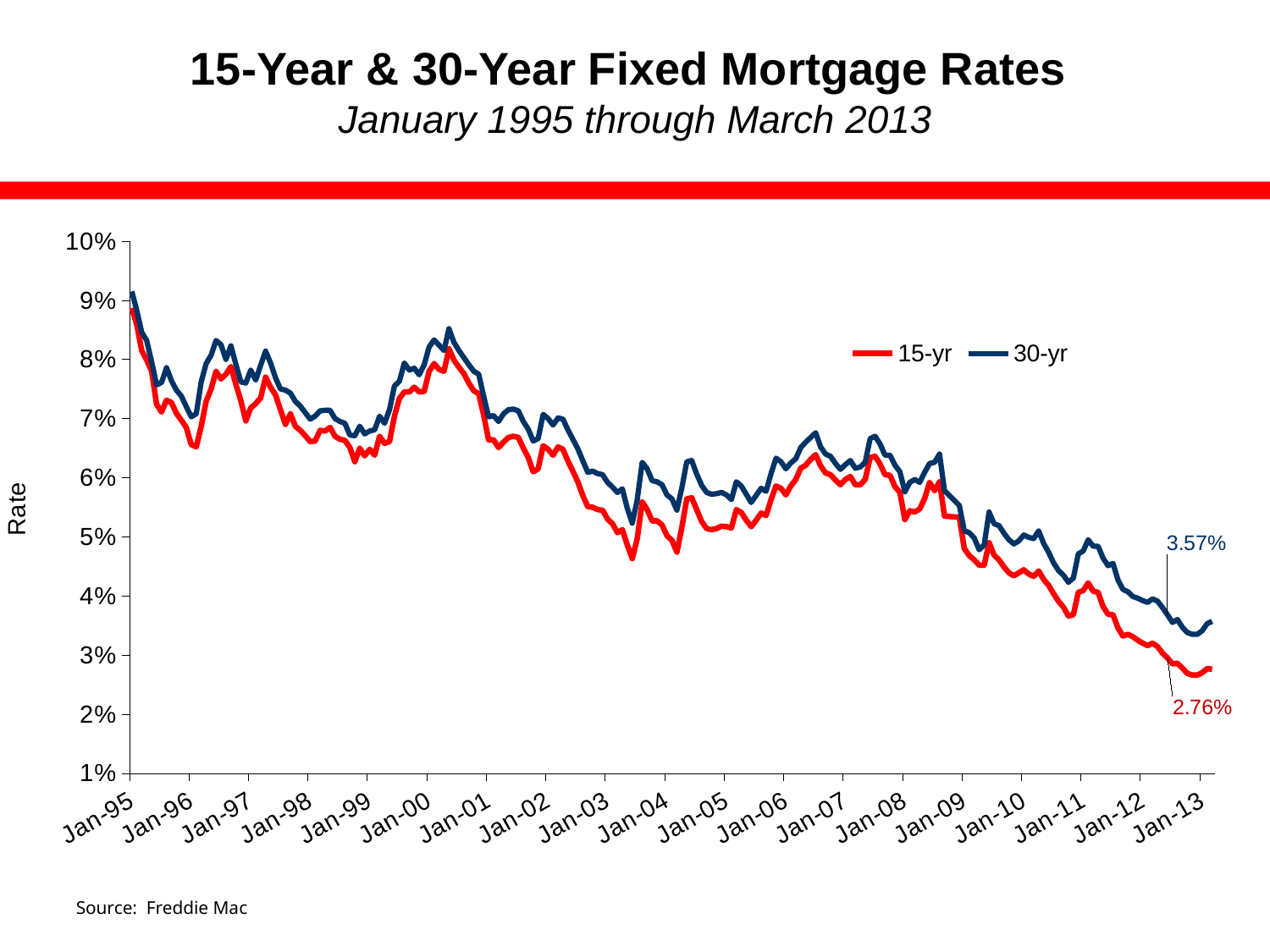
What is the difference between the labelled final values of the 30-yr and 15-yr series? 0.81% How many year labels are shown on the x axis? 19 Do the mortgage rates generally rise or fall from Jan-95 to Jan-13? fall What colour is the 15-yr line? red Is the value for the 30-yr series at Jan-95 greater or less than 8%? greater What is the labelled final value of the 30-yr series? 3.57% Is the value for the 15-yr series at Jan-04 greater or less than 6%? less What is the labelled final value of the 15-yr series? 2.76% What kind of chart is shown on the slide? line chart How many series does the legend list? 2 At the end of the chart, which series has the higher rate, 15-yr or 30-yr? 30-yr Is the value for the 30-yr series at Jan-07 greater or less than 7%? less